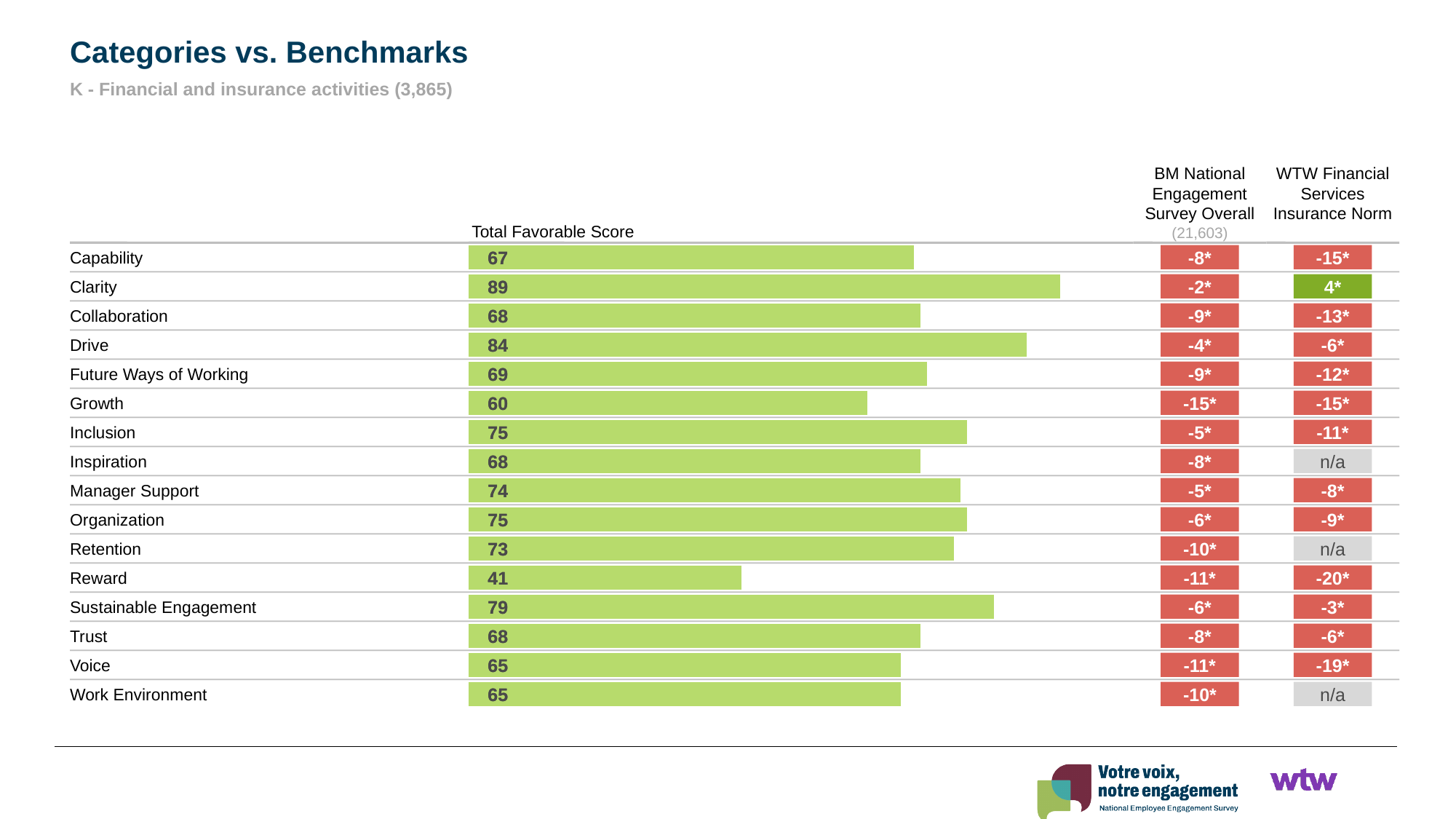
Which has a higher Total Favorable Score, Drive or Growth? Drive What is the Total Favorable Score for Reward? 41 What is the difference versus the BM National Engagement Survey Overall for Growth? -15* What kind of chart is used to show the Total Favorable Scores? Bar chart What is the difference between the Total Favorable Scores for Clarity and Reward? 48 What is the difference versus the WTW Financial Services Insurance Norm for Reward? -20* Which category has the lowest Total Favorable Score? Reward Which category is the only one with a positive difference versus the WTW Financial Services Insurance Norm? Clarity What is the Total Favorable Score for Clarity? 89 Which category has the highest Total Favorable Score? Clarity How many categories are shown in the chart? 16 What is the Total Favorable Score for Sustainable Engagement? 79